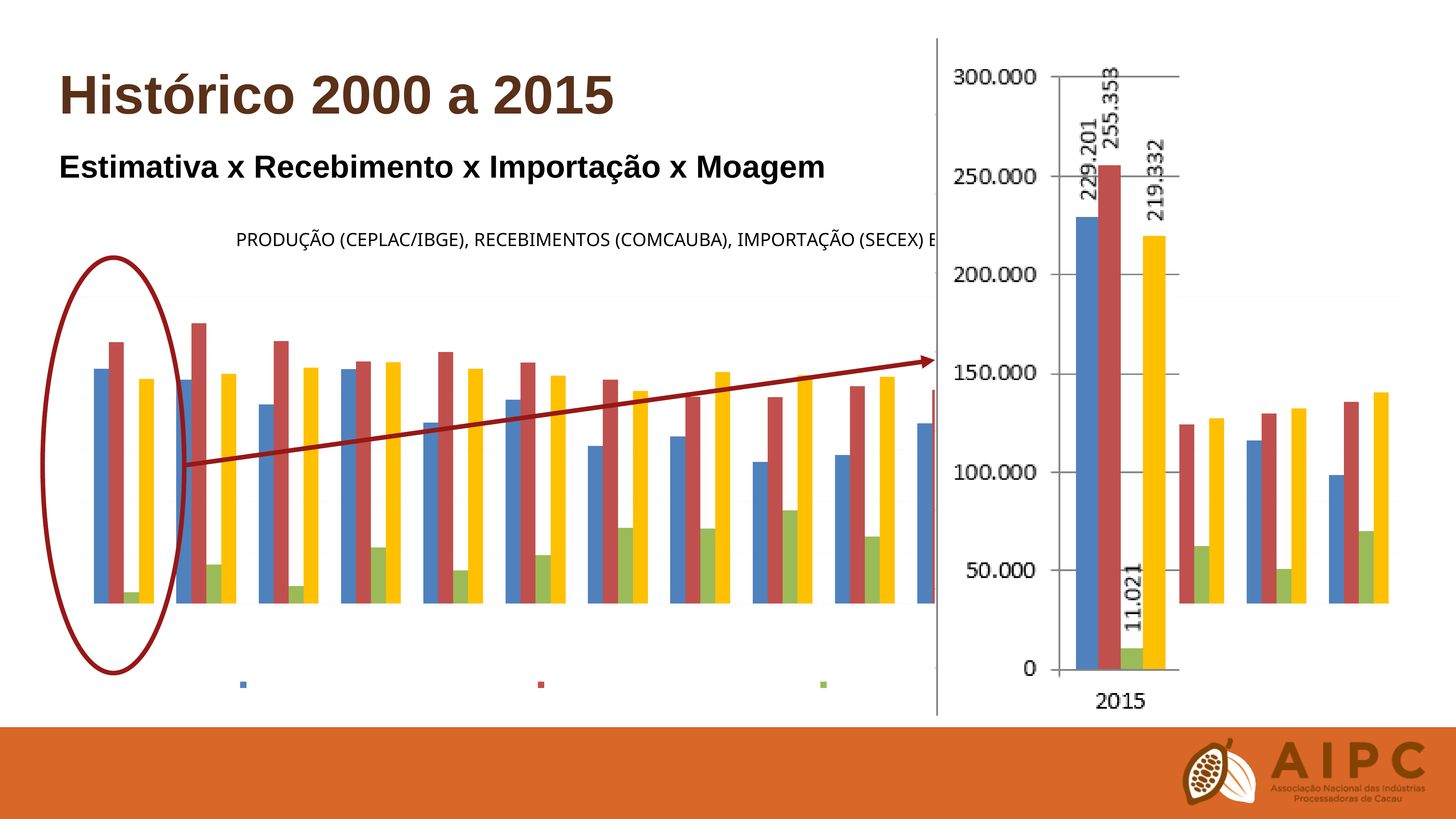
In the inset chart on the right for 2015, is the value of the green bar greater or less than 50.000? less In the inset chart on the right for 2015, which coloured bar has the lowest value? Green What kind of chart is the inset chart on the right? Bar chart In the inset chart on the right for 2015, what is the value of the red bar? 255.353 In the inset chart on the right for 2015, which coloured bar has the highest value? Red In the inset chart on the right for 2015, what is the value of the blue bar? 229.201 In the inset chart on the right for 2015, what is the difference between the red bar and the blue bar? 26.152 In the inset chart on the right for 2015, what is the difference between the blue bar and the yellow bar? 9.869 In the inset chart on the right for 2015, what is the value of the yellow bar? 219.332 In the inset chart on the right for 2015, which is larger, the blue bar or the yellow bar? Blue bar In the inset chart on the right for 2015, what is the value of the green bar? 11.021 How many bars are shown in the inset chart on the right for 2015? 4